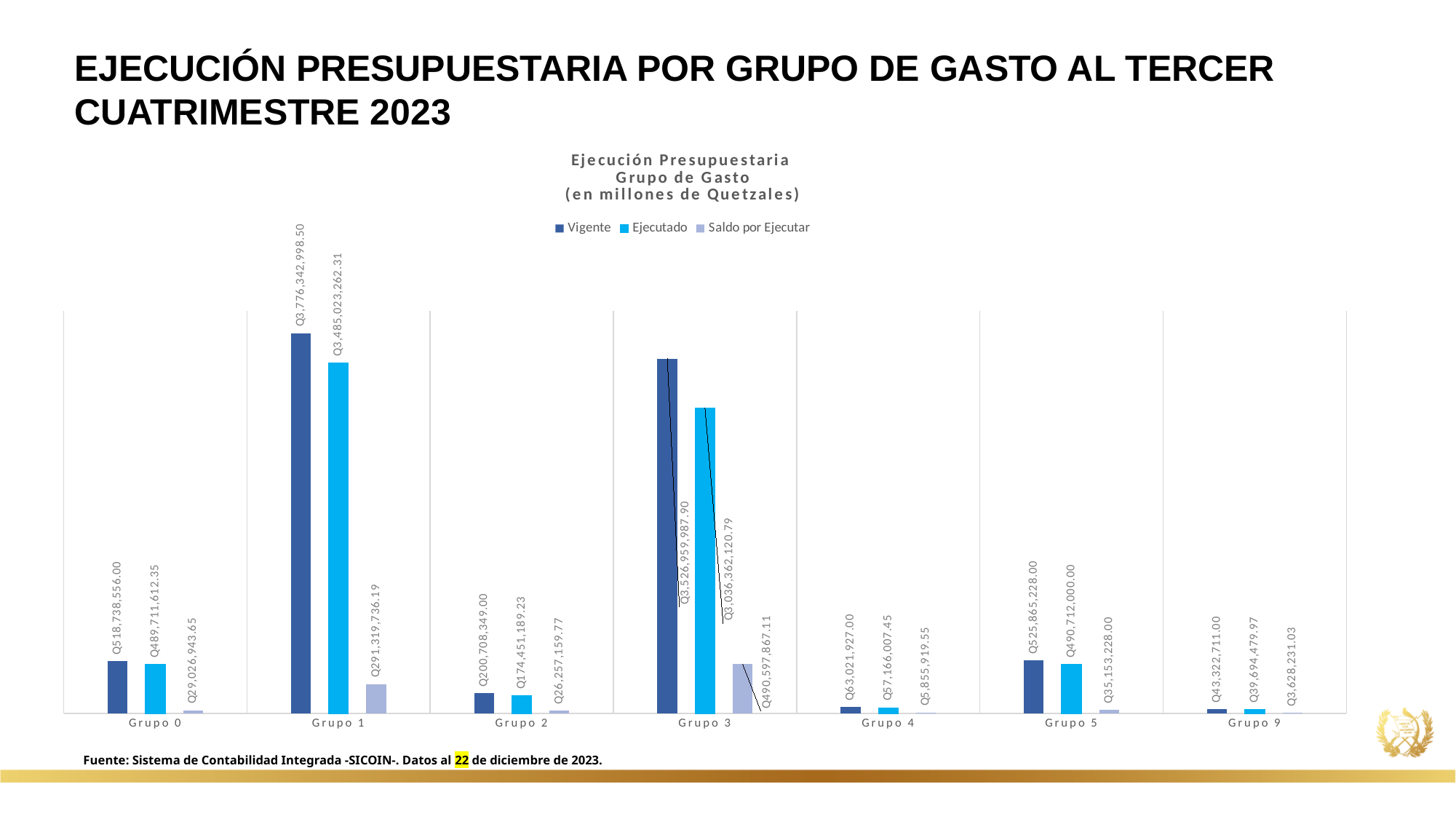
What is the Saldo por Ejecutar value for Grupo 4? Q5,855,919.55 How many grupos (categories) are shown on the x axis? 7 What is the Ejecutado value for Grupo 9? Q39,694,479.97 Which is larger, the Vigente value for Grupo 2 or for Grupo 4? Grupo 2 What type of chart is shown on the slide? Bar chart How many series does the legend list? 3 What is the Ejecutado value for Grupo 3? Q3,036,362,120.79 Which series is shown in the lightest (pale lavender) colour in the legend? Saldo por Ejecutar What is the difference between the Vigente and Ejecutado values for Grupo 5? Q35,153,228.00 What is the Vigente value for Grupo 1? Q3,776,342,998.50 Which grupo has the lowest Saldo por Ejecutar value? Grupo 9 Which grupo has the highest Vigente value? Grupo 1